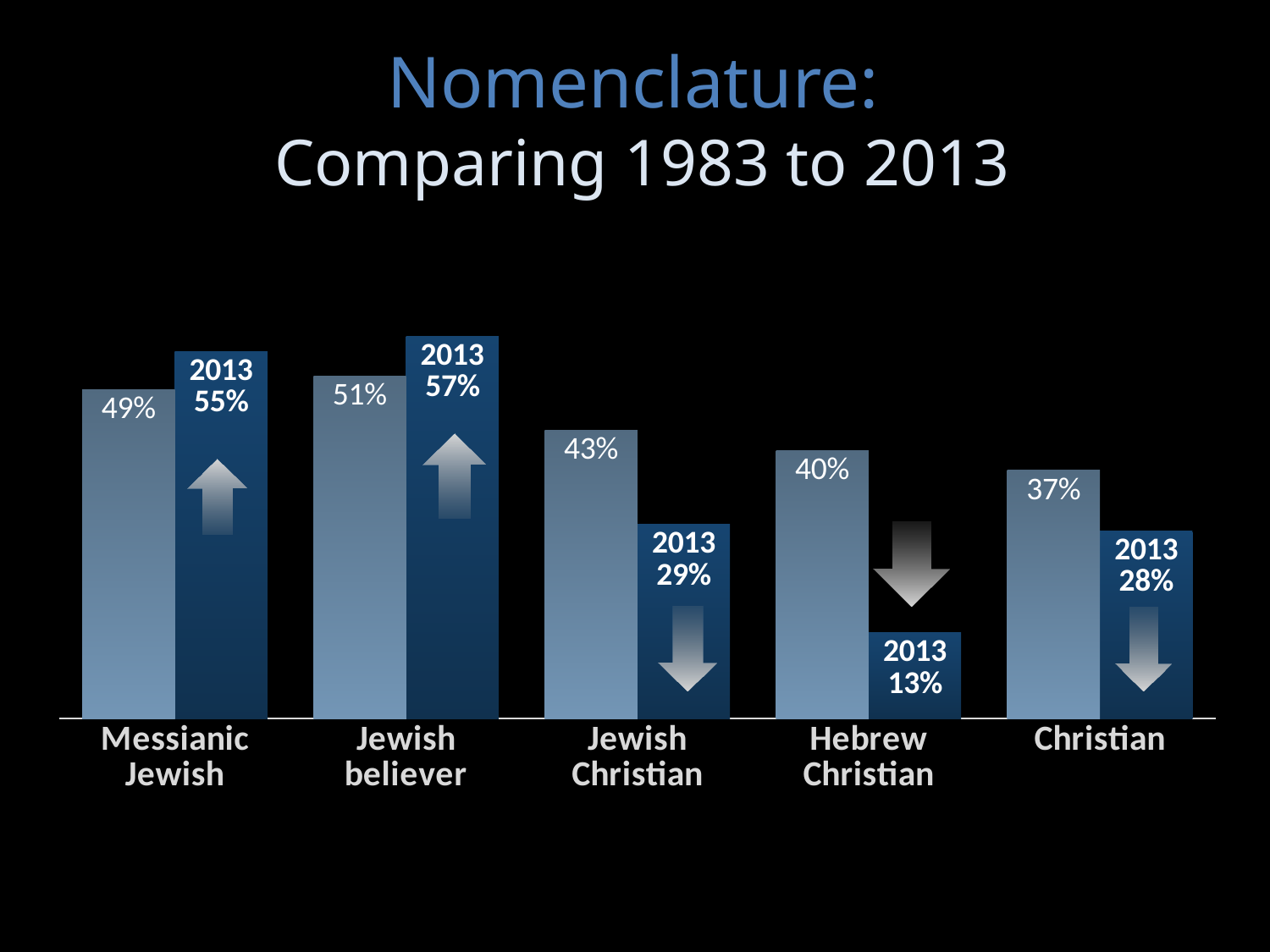
What kind of chart is shown on the slide? Bar chart What is the 1983 value for Christian? 37% What is the difference between the 1983 and 2013 values for Hebrew Christian? 27% Which is larger, the 2013 value for Jewish Christian or the 2013 value for Christian? Jewish Christian How many categories are shown on the chart? 5 What is the 2013 value for Hebrew Christian? 13% What is the difference between the 2013 values for Jewish believer and Jewish Christian? 28% What is the 1983 value for Jewish believer? 51% Which category has the lowest 2013 value? Hebrew Christian Which category has the highest 2013 value? Jewish believer What is the 2013 value for Messianic Jewish? 55% Which category has the lowest 1983 value? Christian